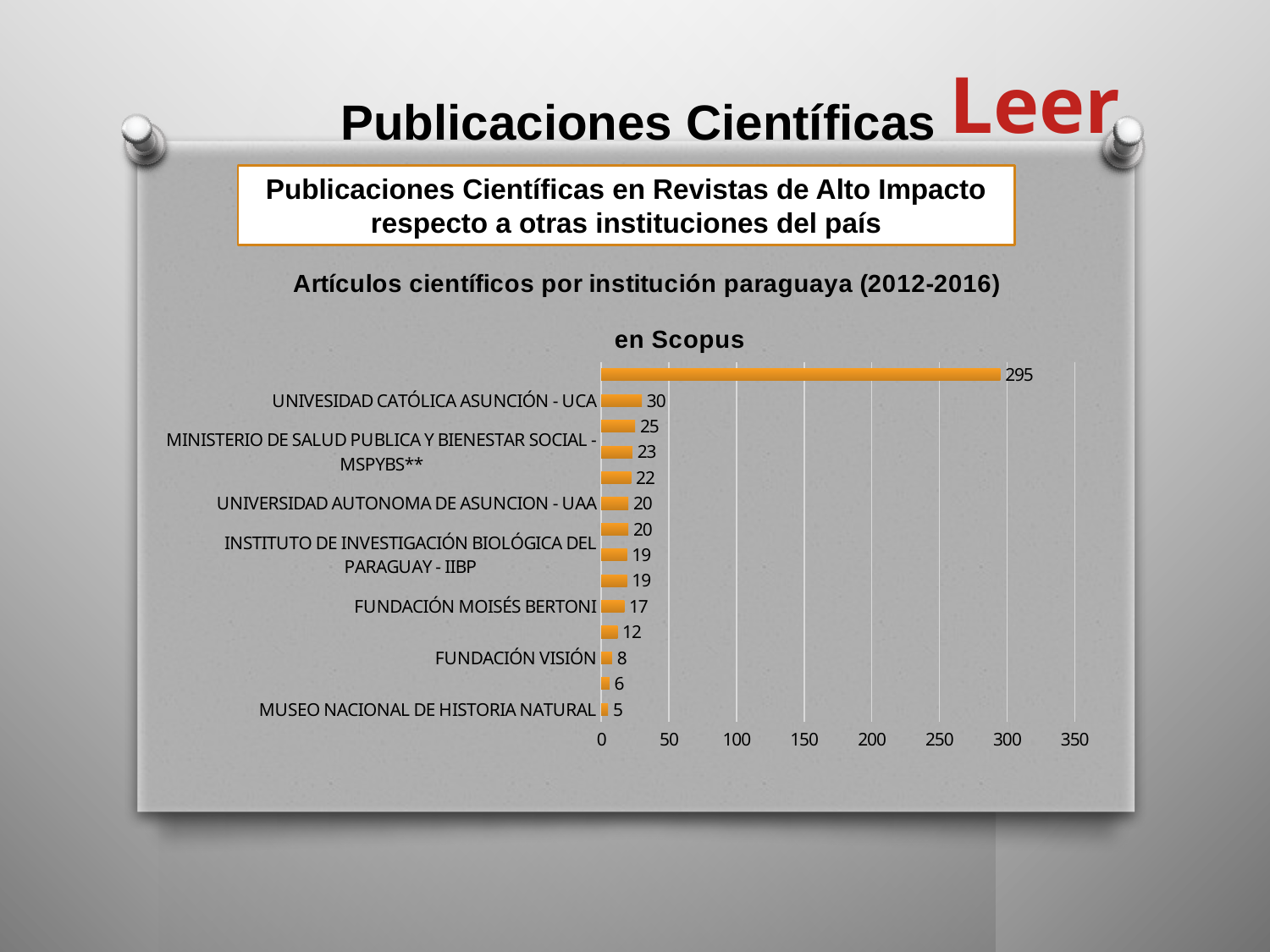
Which labelled institution has the lowest value in the chart? MUSEO NACIONAL DE HISTORIA NATURAL What is the difference between the values for UNIVESIDAD CATÓLICA ASUNCIÓN - UCA and FUNDACIÓN VISIÓN? 22 What is the title of the chart? Artículos científicos por institución paraguaya (2012-2016) en Scopus What value is shown for FUNDACIÓN MOISÉS BERTONI? 17 What value is shown for UNIVERSIDAD AUTONOMA DE ASUNCION - UAA? 20 What value is shown for MINISTERIO DE SALUD PUBLICA Y BIENESTAR SOCIAL - MSPYBS**? 23 How many bars are plotted in the chart? 14 What value is shown for FUNDACIÓN VISIÓN? 8 What is the highest value labelled on the x axis of the chart? 350 What type of chart is shown on the slide? bar chart Which has a higher value, FUNDACIÓN MOISÉS BERTONI or UNIVERSIDAD AUTONOMA DE ASUNCION - UAA? UNIVERSIDAD AUTONOMA DE ASUNCION - UAA How many articles in Scopus are shown for UNIVESIDAD CATÓLICA ASUNCIÓN - UCA? 30